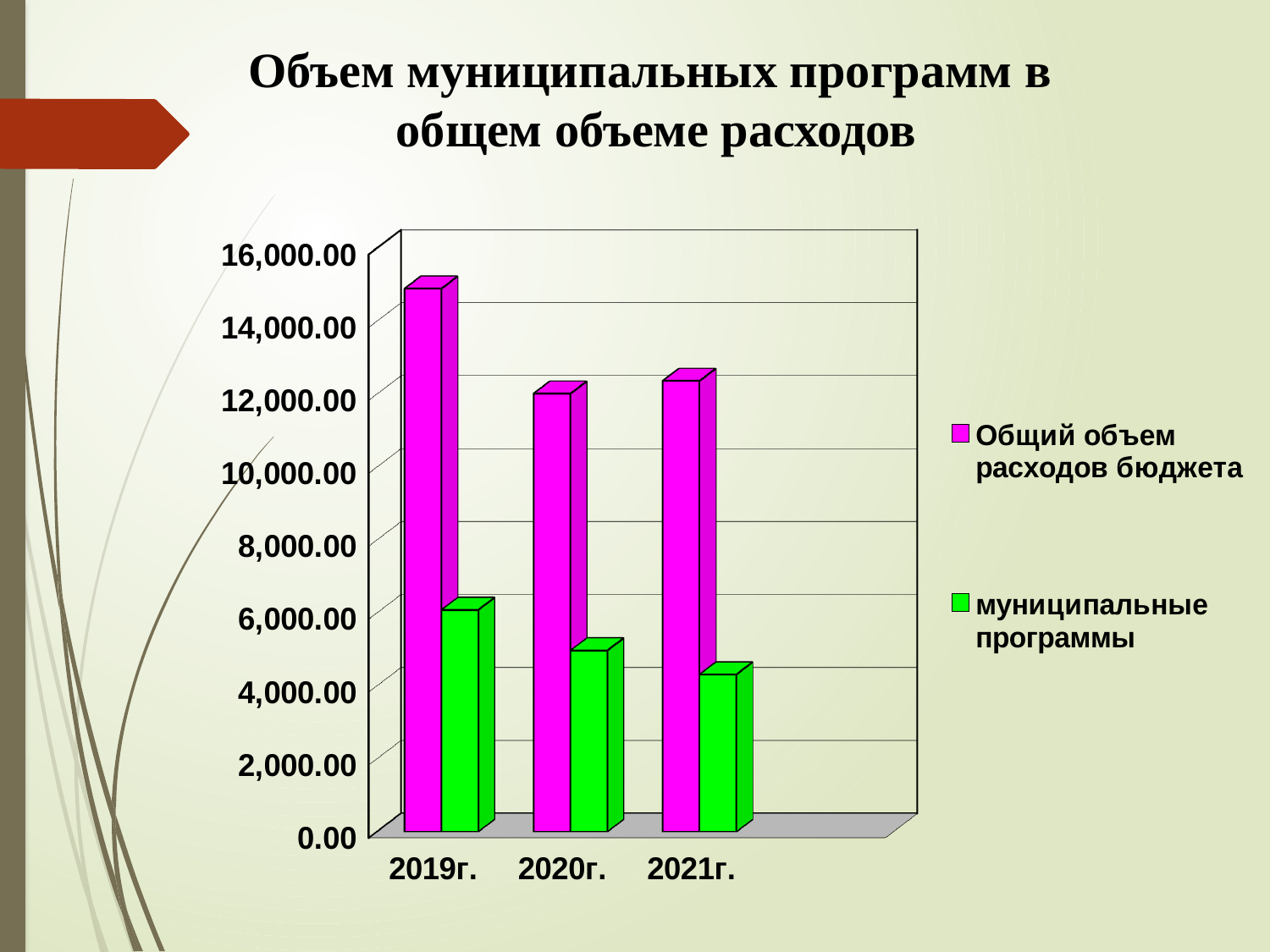
Which is larger: 'Общий объем расходов бюджета' in 2019г. or in 2021г.? 2019г. Which colour represents the series 'муниципальные программы'? green Is the value for 'муниципальные программы' in 2020г. greater or less than 4,000.00? greater How many years are shown on the x axis? 3 Is the value for 'муниципальные программы' in 2020г. greater or less than 6,000.00? less What is the title of the chart? Объем муниципальных программ в общем объеме расходов Do the values for 'муниципальные программы' rise or fall from 2019г. to 2021г.? fall How many series does the legend list? 2 In which year is 'Общий объем расходов бюджета' highest? 2019г. Is the value for 'Общий объем расходов бюджета' in 2019г. greater or less than 14,000.00? greater In which year is 'муниципальные программы' lowest? 2021г. What kind of chart is shown on the slide? bar chart